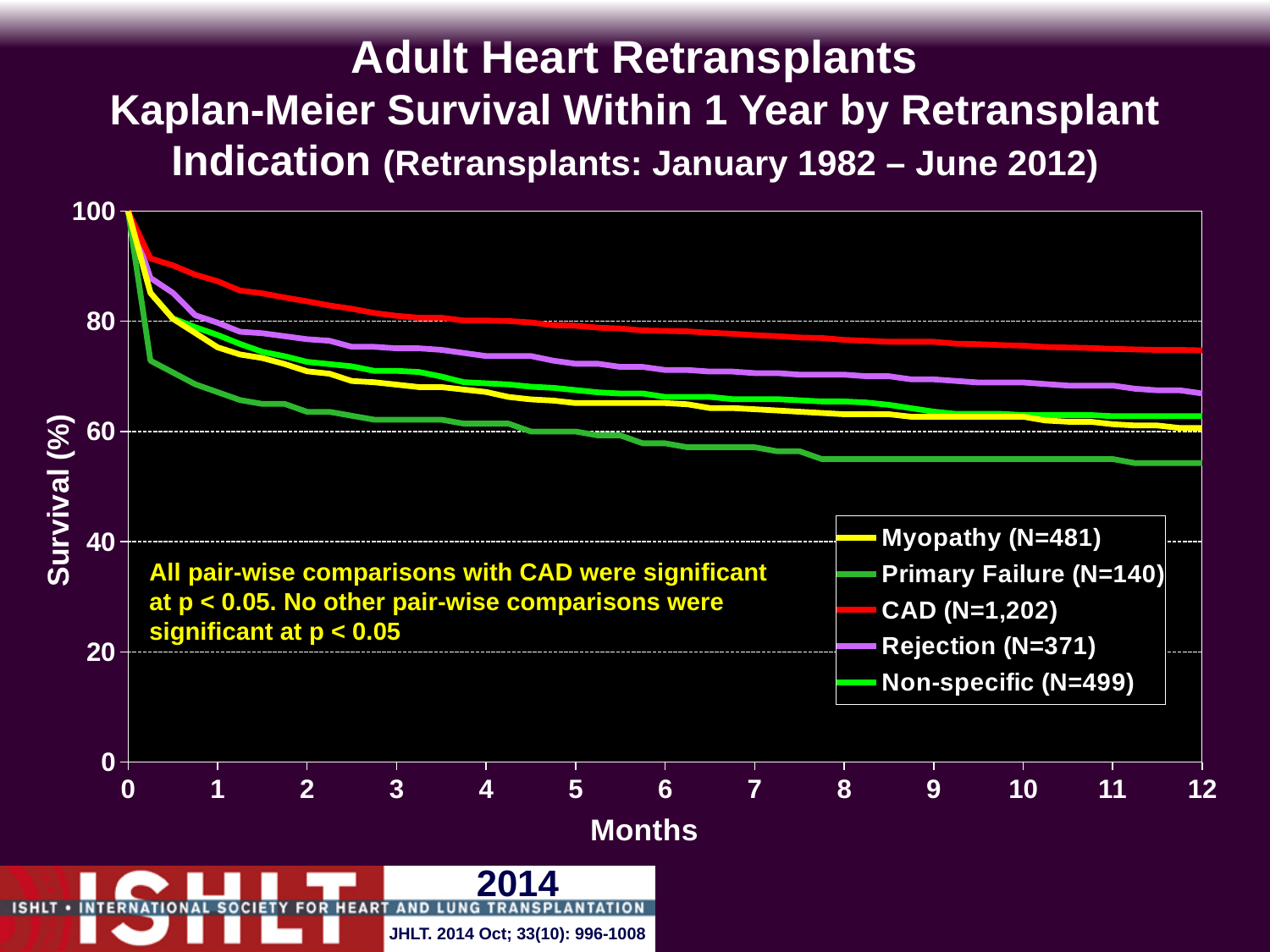
What is the survival (%) for all groups at month 0? 100 Is the survival for Rejection at 12 months greater or less than 60? greater Which retransplant indication has the highest survival at 12 months? CAD Which retransplant indication has the lowest survival at 12 months? Primary Failure Is the survival for Primary Failure at 12 months greater or less than 60? less Is the survival for Primary Failure at 8 months greater or less than 60? less At 6 months, which has higher survival: CAD or Primary Failure? CAD What kind of chart is shown on the slide? line chart How many series does the legend list? 5 Do the survival curves rise or fall as months increase? fall What is the N shown in the legend for CAD? 1,202